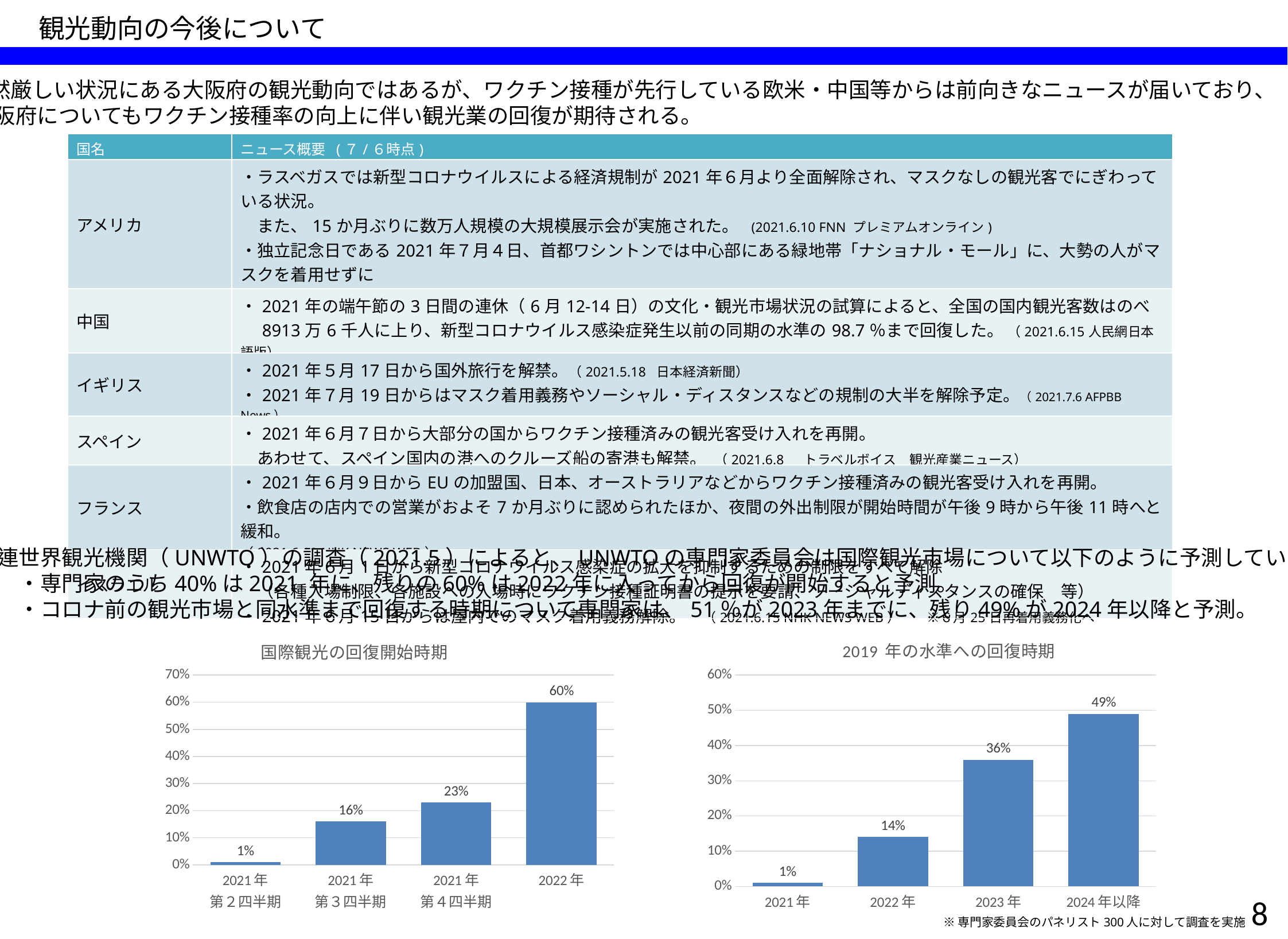
In the chart titled 国際観光の回復開始時期, what is the value for 2022年? 60% In the chart titled 国際観光の回復開始時期, what is the difference between the values for 2022年 and 2021年 第4四半期? 37% In the chart titled 国際観光の回復開始時期, how many categories are shown on the x axis? 4 In the chart titled 2019年の水準への回復時期, which is larger, the value for 2022年 or the value for 2023年? 2023年 What is the title of the chart on the left side of the slide? 国際観光の回復開始時期 In the chart titled 2019年の水準への回復時期, what is the difference between the values for 2024年以降 and 2022年? 35% In the chart titled 国際観光の回復開始時期, which category has the lowest value? 2021年 第2四半期 In the chart titled 国際観光の回復開始時期, what is the value for 2021年 第3四半期? 16% In the chart titled 国際観光の回復開始時期, do the values rise or fall from left to right along the x axis? rise In the chart titled 2019年の水準への回復時期, which category has the highest value? 2024年以降 In the chart titled 2019年の水準への回復時期, what is the value for 2023年? 36% What kind of chart is the chart titled 2019年の水準への回復時期? bar chart